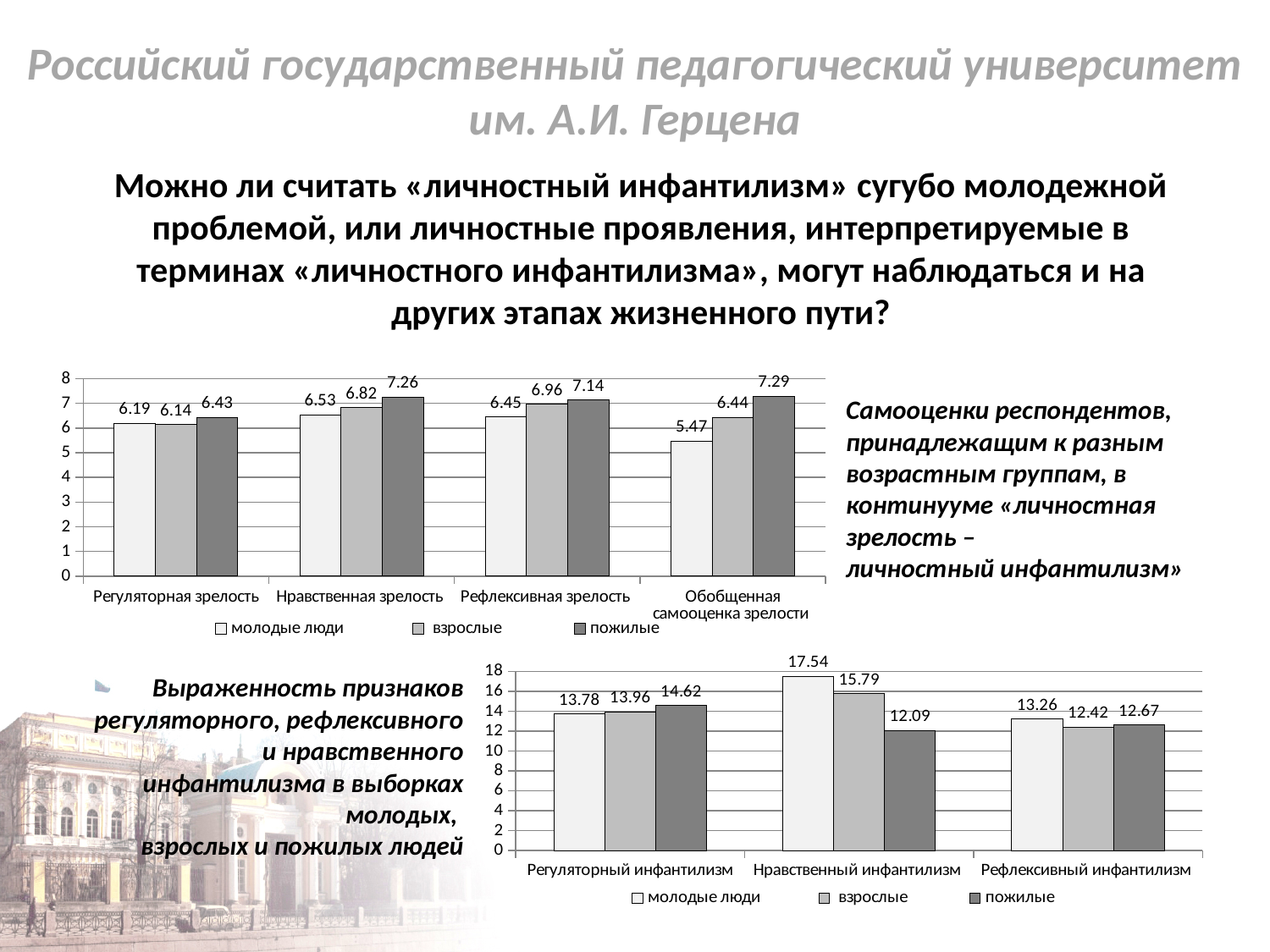
In the top chart, what is the difference between the values for пожилые and молодые люди in the category Обобщенная самооценка зрелости? 1.82 In the top chart, how many categories are shown on the x axis? 4 In the bottom chart, which series has the highest value in the category Нравственный инфантилизм? молодые люди In the bottom chart, what is the value for молодые люди in the category Нравственный инфантилизм? 17.54 In the top chart, how many series does the legend list? 3 In the bottom chart, which is larger in the category Регуляторный инфантилизм: the value for молодые люди or for пожилые? пожилые In the top chart, which category has the lowest value for молодые люди? Обобщенная самооценка зрелости In the bottom chart, what is the difference between the values for молодые люди and пожилые in the category Нравственный инфантилизм? 5.45 What type of chart is the bottom chart? bar chart In the top chart, what is the value for пожилые in the category Обобщенная самооценка зрелости? 7.29 In the top chart, what is the value for молодые люди in the category Нравственная зрелость? 6.53 In the bottom chart, what is the value for взрослые in the category Рефлексивный инфантилизм? 12.42